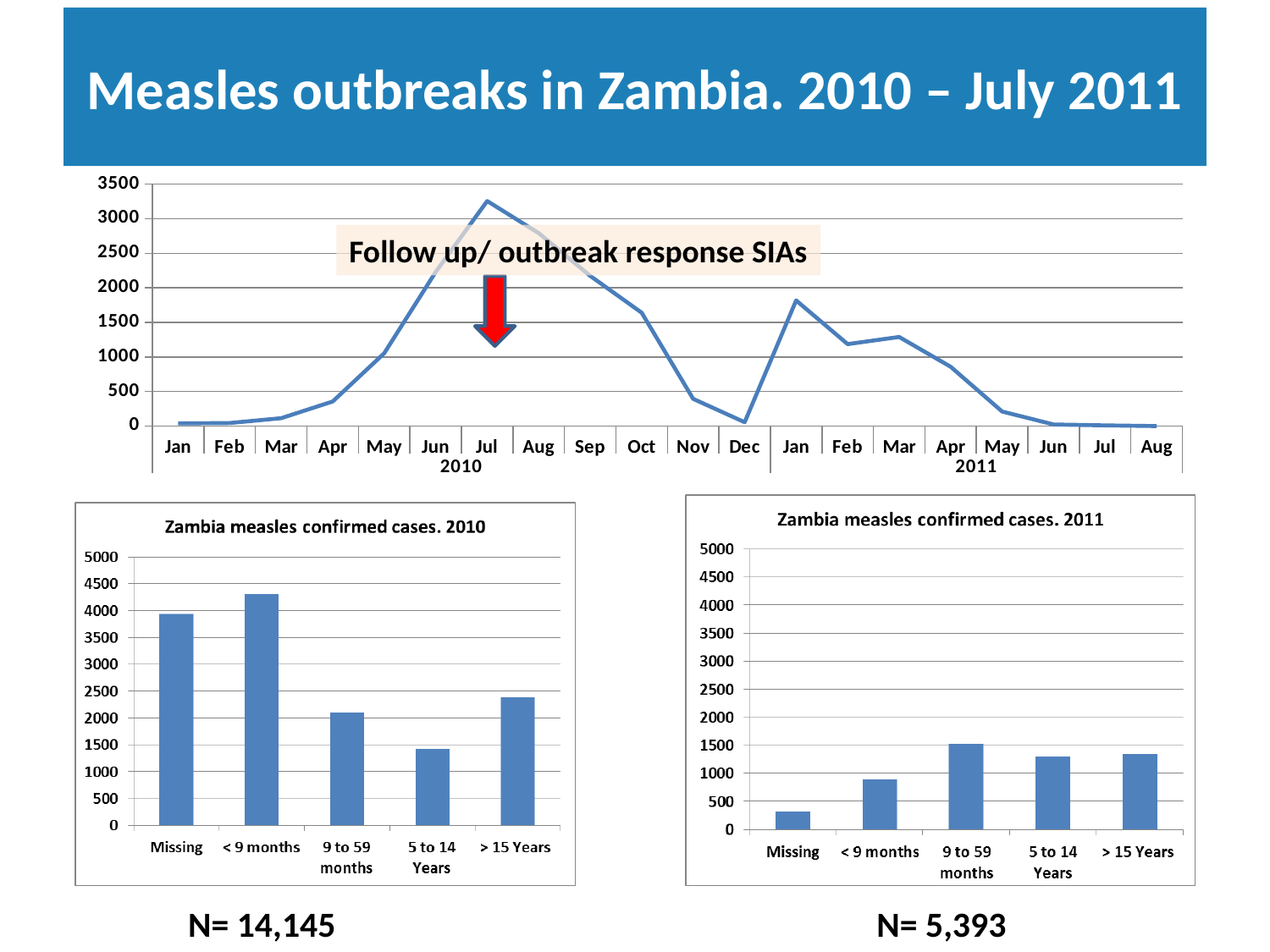
In the chart 'Zambia measles confirmed cases. 2011', is the value for Missing greater or less than 500? less In the top line chart, which month has the highest number of cases? Jul 2010 In the chart 'Zambia measles confirmed cases. 2010', which age group has the lowest number of cases? 5 to 14 Years In the top line chart, is the value for Dec 2010 greater or less than 500? less What text does the annotation box on the top line chart show? Follow up/ outbreak response SIAs In the chart 'Zambia measles confirmed cases. 2010', is the value for Missing greater or less than 3500? greater In the chart 'Zambia measles confirmed cases. 2011', which age group has the highest number of cases? 9 to 59 months In the chart 'Zambia measles confirmed cases. 2010', which age group has the highest number of cases? < 9 months What kind of chart is the top chart showing monthly measles cases from 2010 to 2011? Line chart In the top line chart, how many monthly data points are plotted? 20 In the top line chart, do the values rise or fall from Jul 2010 to Dec 2010? fall